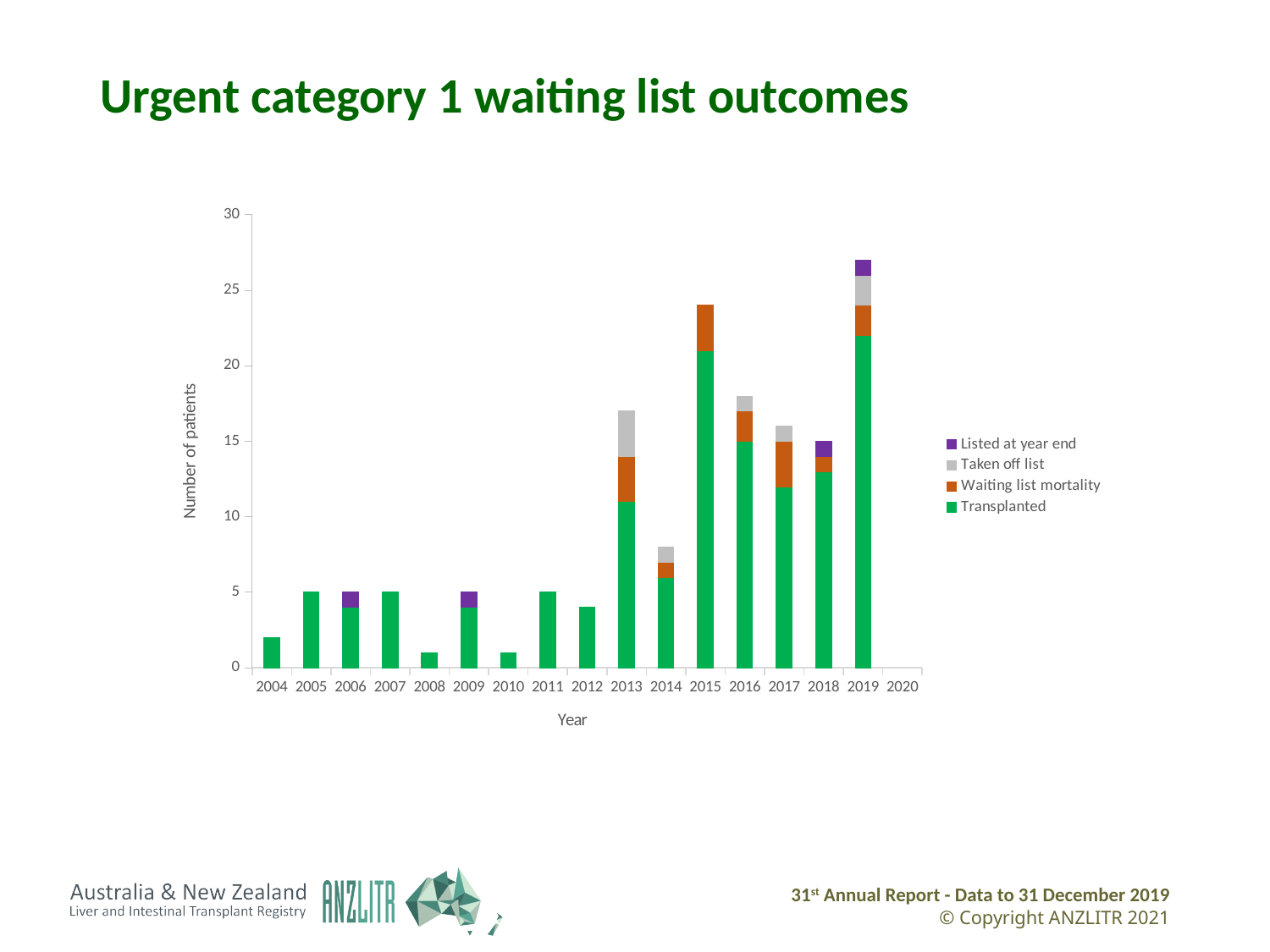
Which colour represents the Transplanted series in the legend? Green Which year has the tallest stacked bar? 2019 Which year has the larger total, 2015 or 2016? 2015 What kind of chart is shown on the slide? Stacked bar chart Is the total for 2019 greater or less than 25? greater What is the total height of the stacked bar for 2018? 15 Is the total for 2015 greater or less than 20? greater What is the total number of patients for 2005? 5 Do the bar totals rise or fall from 2016 to 2018? fall Is the total for 2014 greater or less than 10? less How many series does the legend list? 4 How many years are labelled on the x axis? 17